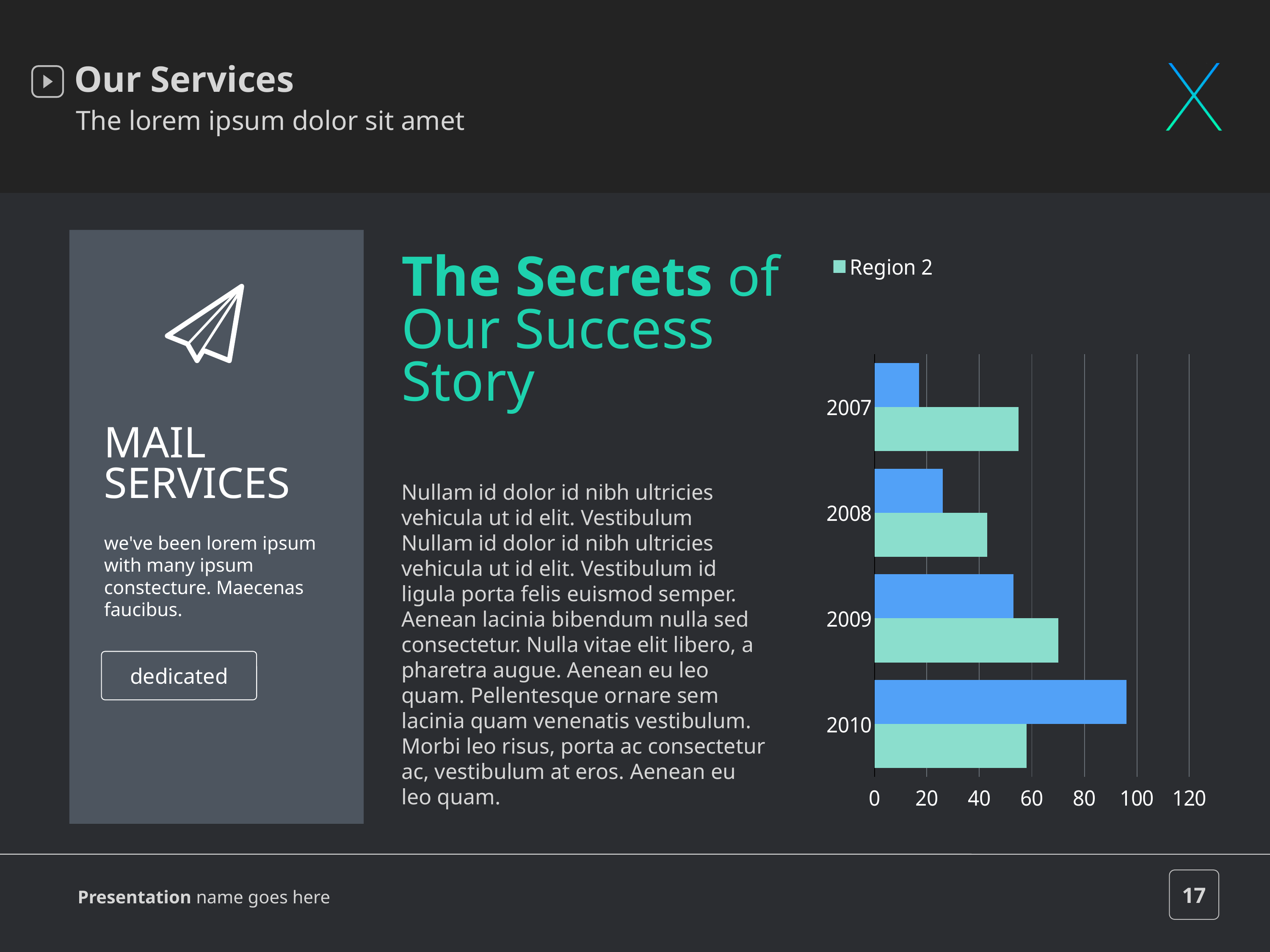
Which year has the lowest value for Region 2? 2008 What kind of chart is shown on the slide? bar chart Is the Region 2 value for 2008 greater or less than 60? less For 2010, which bar is longer, the blue bar or the Region 2 bar? the blue bar Is the value of the blue bar for 2010 greater or less than 80? greater Which year has the longest blue bar? 2010 Which year has the highest value for Region 2? 2009 Which year has the shortest blue bar? 2007 What is the name of the series listed in the chart's legend? Region 2 How many years are shown on the chart's vertical axis? 4 Is the Region 2 value for 2009 greater or less than 60? greater How many series does the chart's legend list? 1